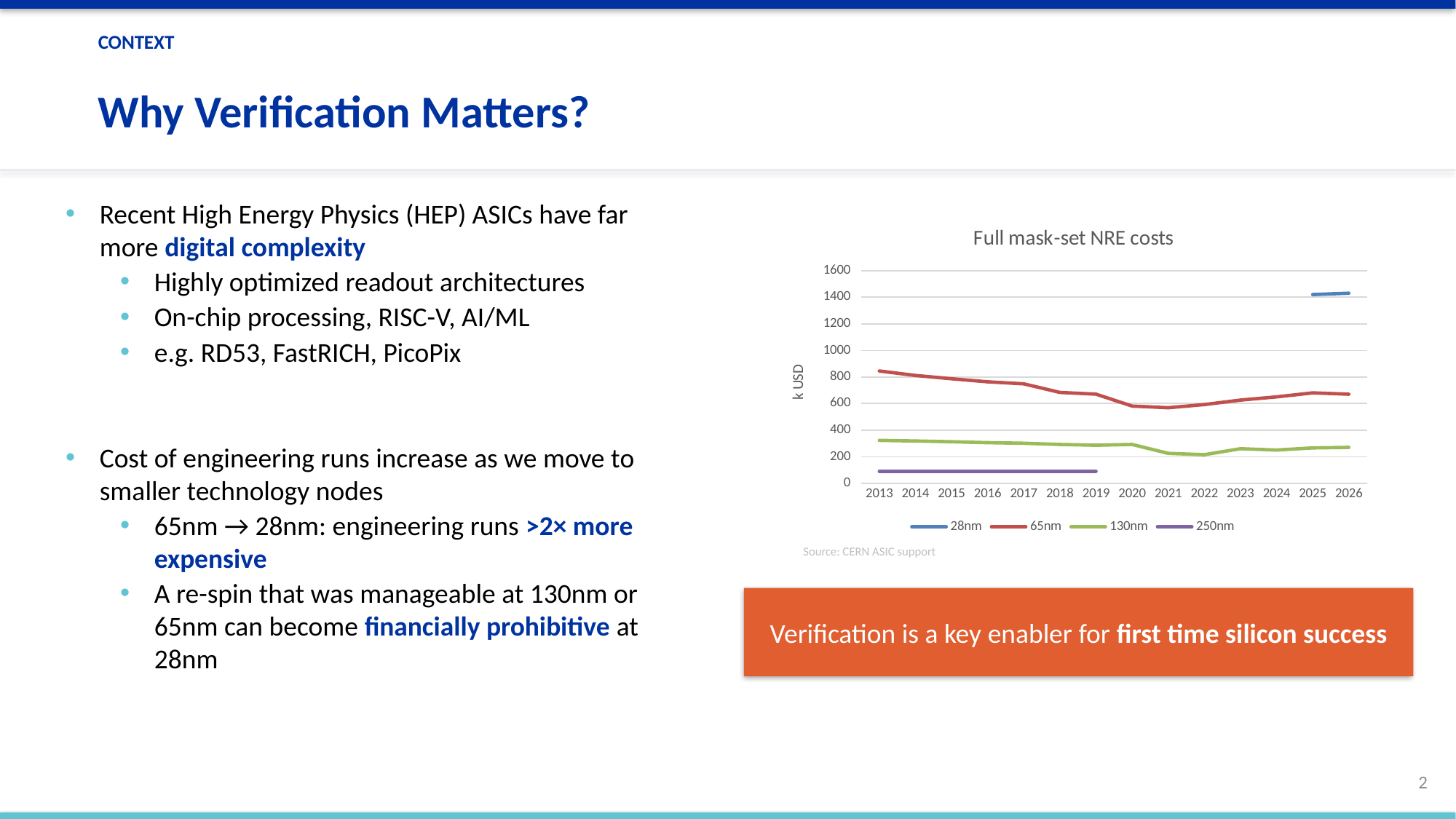
Is the value for 28nm in 2026 greater or less than 1200? greater Does the 65nm series rise or fall from 2013 to 2021? fall What kind of chart is shown on the slide? line chart How many years are shown on the x axis of the 'Full mask-set NRE costs' chart? 14 Is the value for 130nm in 2022 greater or less than 400? less Which series has the lowest value in 2015? 250nm Which series has the highest value in 2026? 28nm What is the label on the y axis of the chart? k USD Is the value for 65nm in 2013 greater or less than 1000? less In 2020, which series has the larger value, 65nm or 130nm? 65nm How many series does the legend of the 'Full mask-set NRE costs' chart list? 4